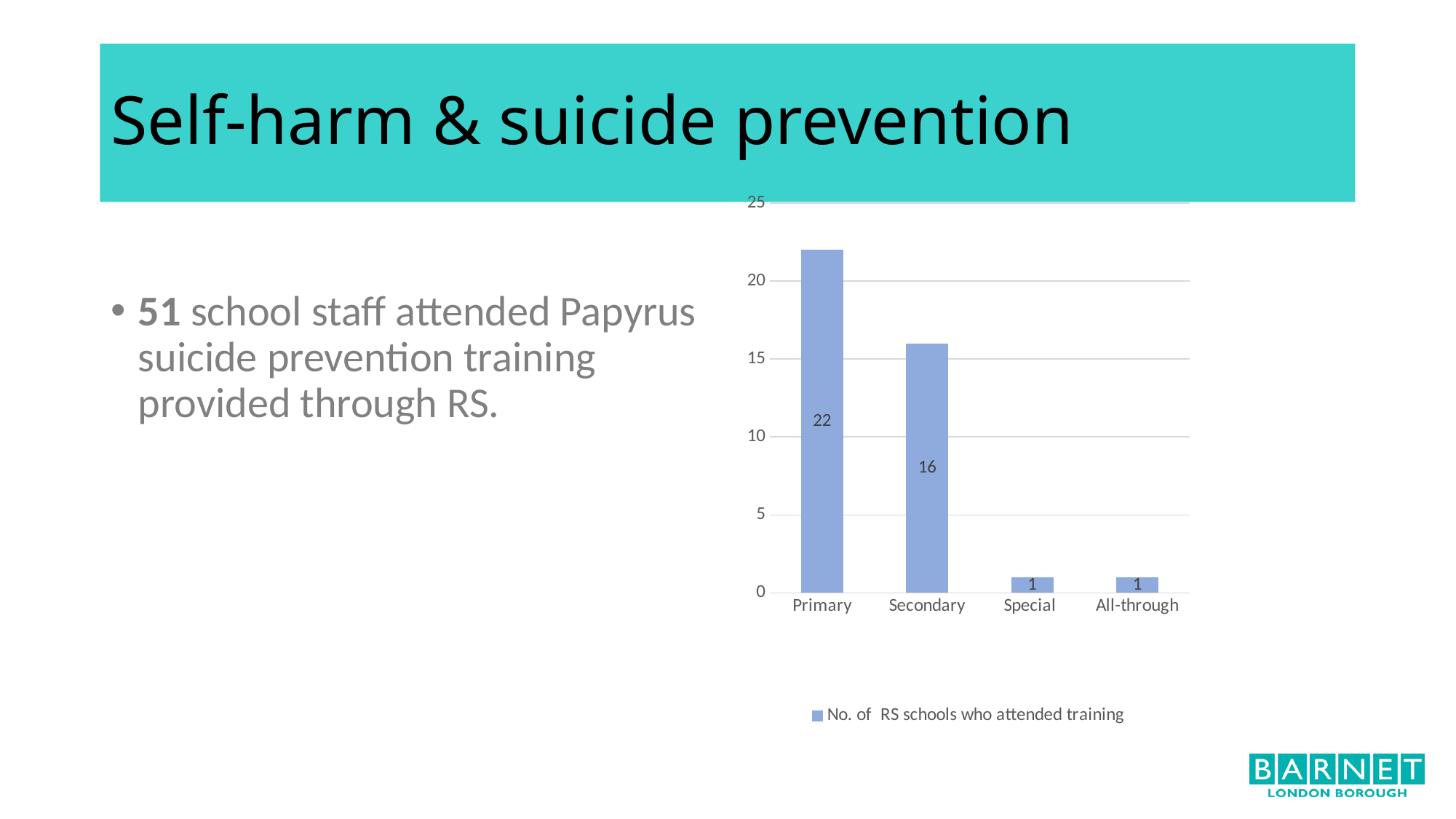
What is the legend entry of the chart? No. of RS schools who attended training What kind of chart is shown on the slide? Bar chart How many series does the chart legend list? 1 Is the value for Primary greater or less than 20? greater What is the difference between the Primary and Secondary values? 6 Which is larger, the value for Secondary or the value for All-through? Secondary What is the number of RS schools who attended training for Primary? 22 Which school type has the highest number of RS schools who attended training? Primary What is the number of RS schools who attended training for Secondary? 16 What is the total of all four values in the chart? 40 What is the number of RS schools who attended training for Special? 1 How many school types are shown on the x axis of the chart? 4